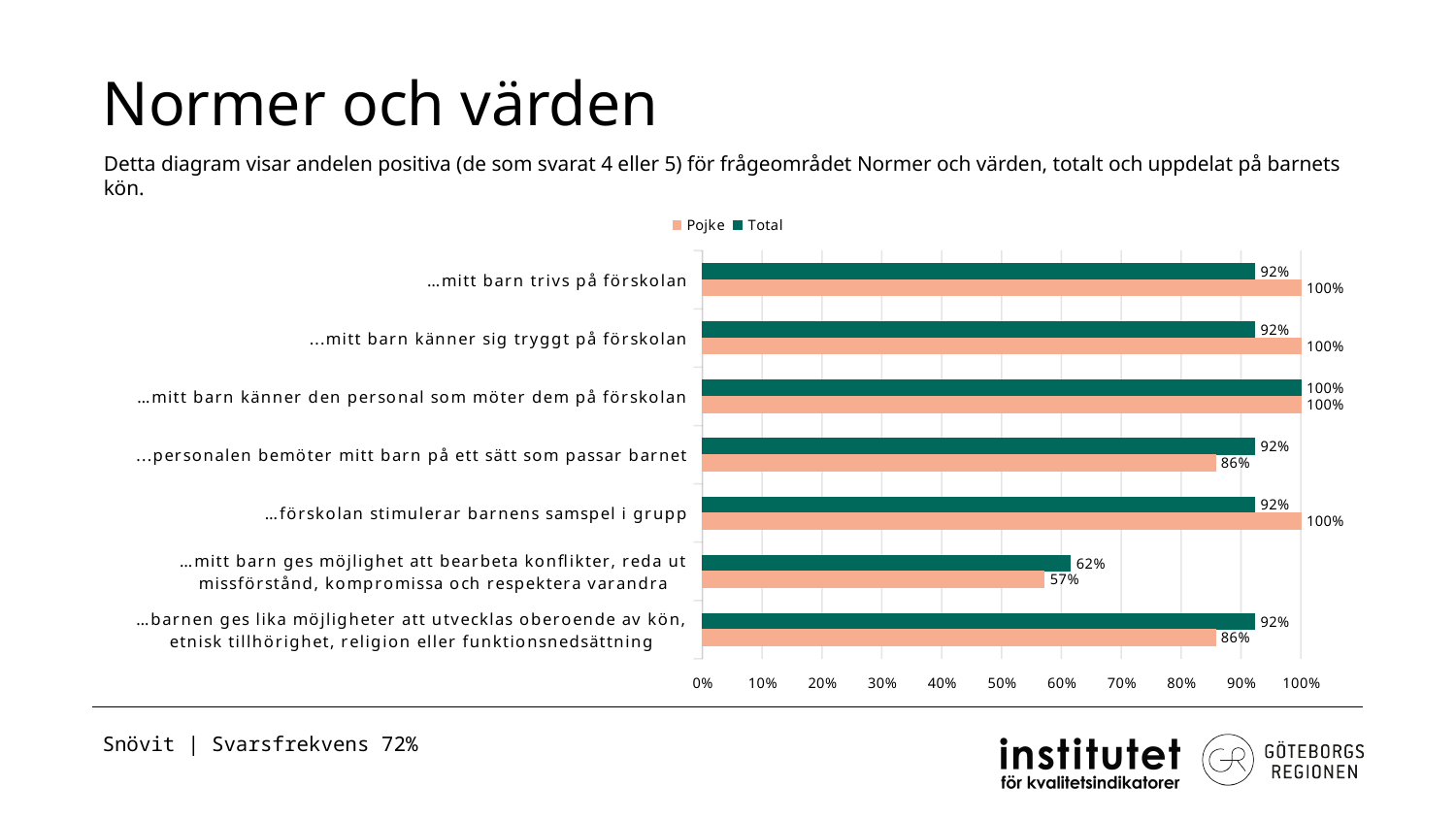
What is the Total value for "…mitt barn trivs på förskolan"? 92% Which category has the highest Total value? …mitt barn känner den personal som möter dem på förskolan Which category has the lowest Pojke value? …mitt barn ges möjlighet att bearbeta konflikter, reda ut missförstånd, kompromissa och respektera varandra How many categories (statements) are plotted in the chart? 7 What is the Total value for "…mitt barn ges möjlighet att bearbeta konflikter, reda ut missförstånd, kompromissa och respektera varandra"? 62% What type of chart is shown on the slide? bar chart How many series does the legend list? 2 Which series is shown in dark green in the legend? Total For "…förskolan stimulerar barnens samspel i grupp", which is larger, the Pojke value or the Total value? Pojke What is the Pojke value for "…mitt barn trivs på förskolan"? 100% What is the Pojke value for "...personalen bemöter mitt barn på ett sätt som passar barnet"? 86% What is the difference between the Total and Pojke values for "…barnen ges lika möjligheter att utvecklas oberoende av kön, etnisk tillhörighet, religion eller funktionsnedsättning"? 6 percentage points